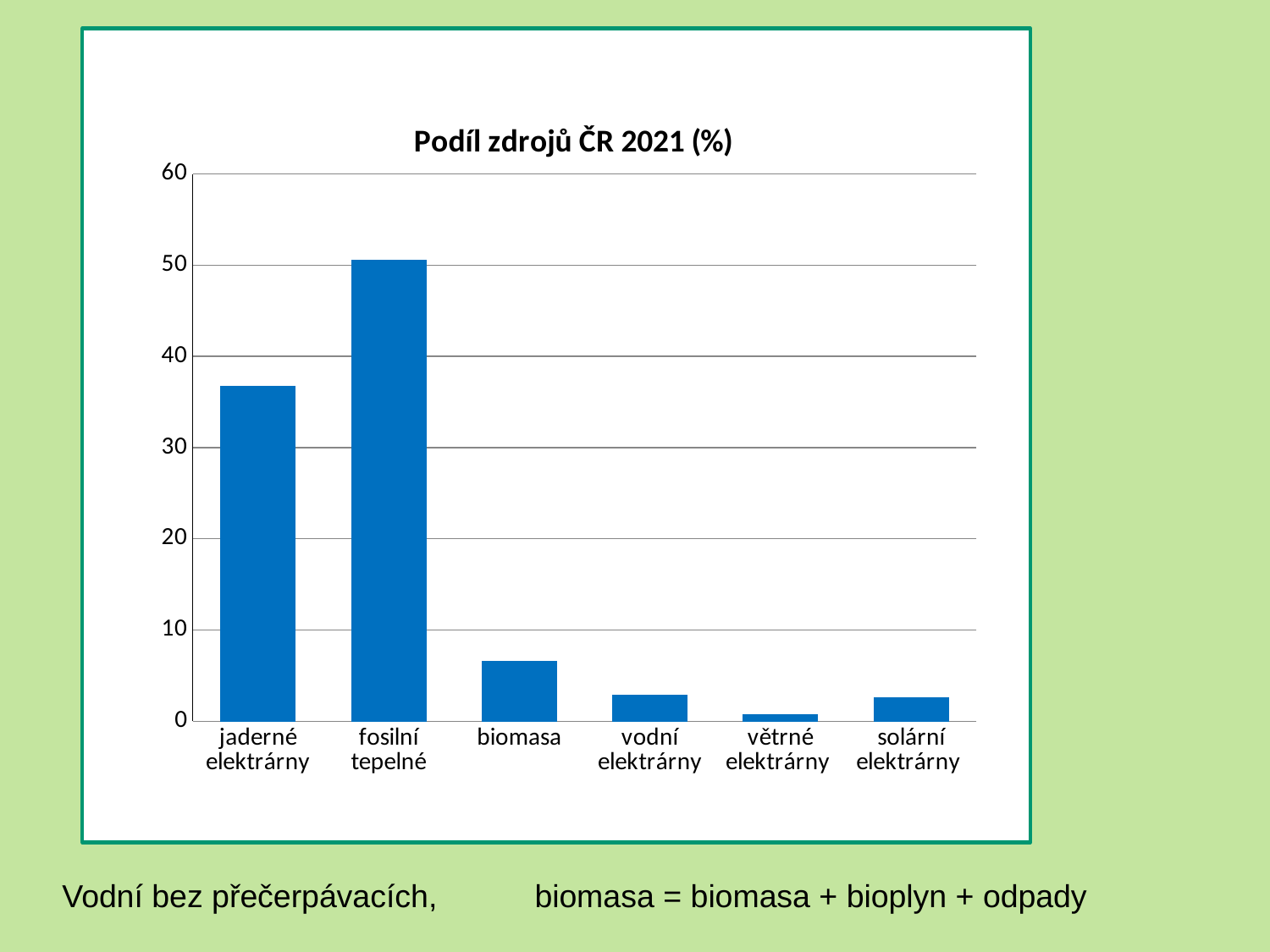
Is the value for biomasa greater or less than 10? less What is the title of the chart? Podíl zdrojů ČR 2021 (%) What kind of chart is shown on the slide? bar chart Which is larger, the value for jaderné elektrárny or the value for fosilní tepelné? fosilní tepelné How many categories are shown on the x axis of the chart? 6 Which category has the lowest value in the chart? větrné elektrárny What is the highest value shown on the vertical axis of the chart? 60 Is the value for jaderné elektrárny greater or less than 30? greater Is the value for jaderné elektrárny greater or less than 40? less Which category has the highest value in the chart? fosilní tepelné Which is larger, the value for biomasa or the value for vodní elektrárny? biomasa